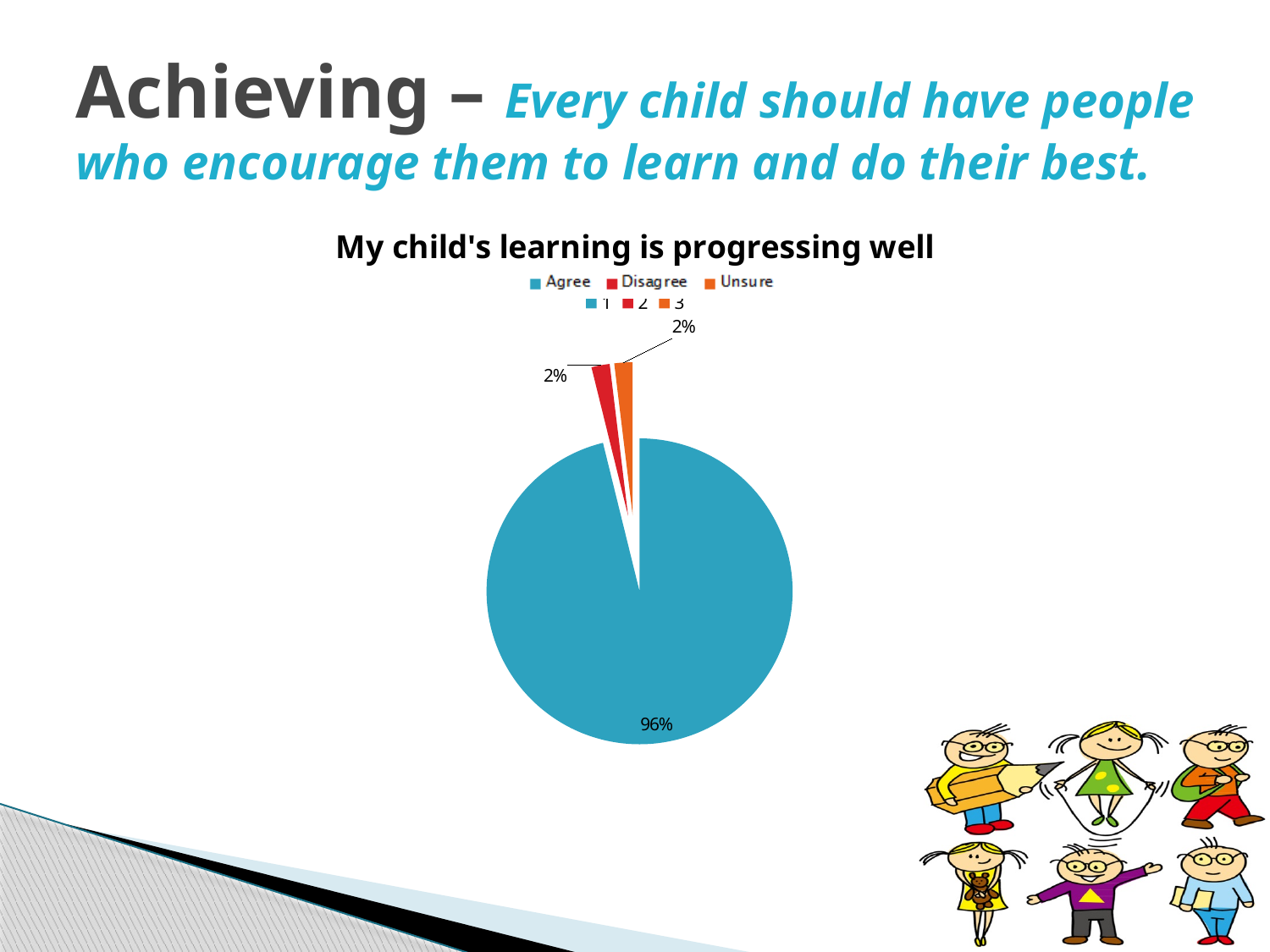
What is the title of the chart? My child's learning is progressing well What percentage of respondents agree that their child's learning is progressing well? 96% Which response category has the largest share of the pie? Agree What is the difference between the Agree share and the Unsure share? 94% How many slices does the pie chart have? 3 What type of chart is shown on the slide? pie chart What percentage of respondents disagree? 2% What is the combined share of Disagree and Unsure? 4% What colour is the Agree slice of the pie? blue What percentage of respondents are unsure? 2% Which is larger, the share for Agree or the share for Disagree? Agree